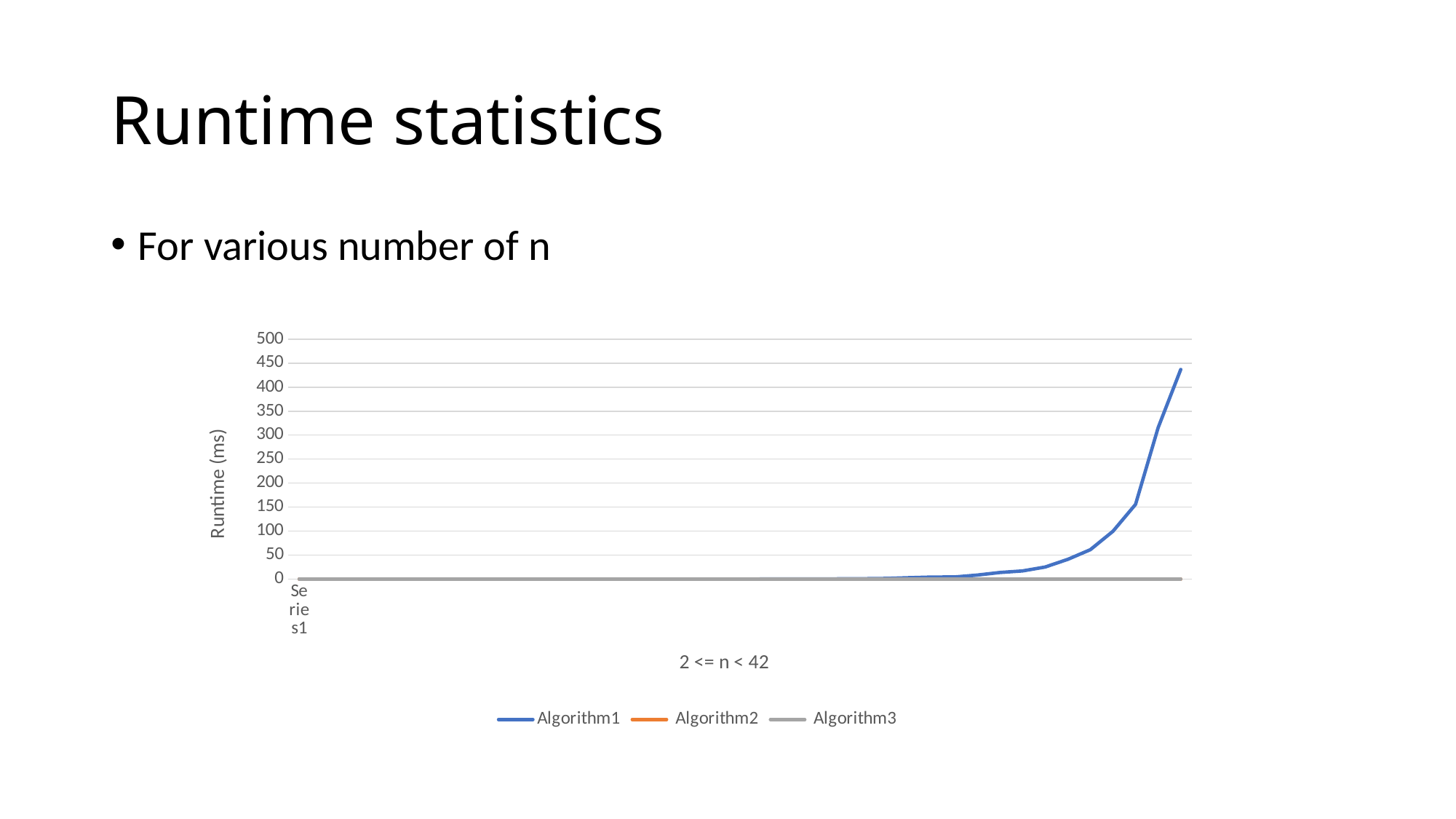
Is the highest value reached by Algorithm1 greater or less than 400? greater Is the highest value reached by Algorithm1 greater or less than 450? less Which series are listed in the legend? Algorithm1, Algorithm2, Algorithm3 Which series reaches the highest runtime on the chart? Algorithm1 How many series does the legend list? 3 At the right end of the x axis, which series has the larger runtime, Algorithm1 or Algorithm3? Algorithm1 What is the highest tick value shown on the vertical axis? 500 Is the runtime of Algorithm3 at the right end of the x axis greater or less than 50? less What is the title of the vertical axis? Runtime (ms) What kind of chart is shown on the slide? line chart Does the Algorithm1 line rise or fall as n increases along the x axis? rise